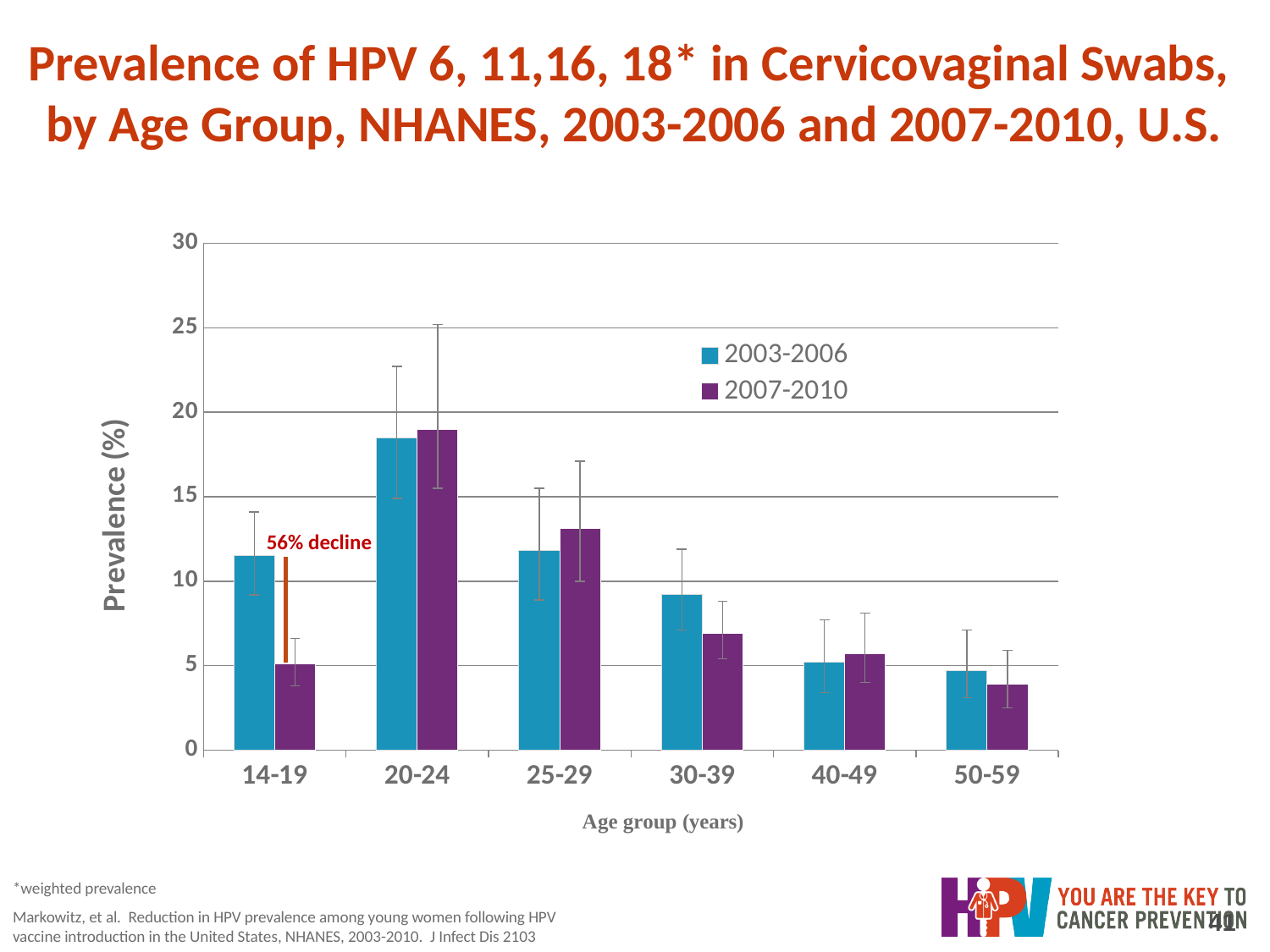
Which age group has the lowest prevalence for the 2007-2010 series? 50-59 How many series does the legend list? 2 Is the 2007-2010 prevalence for the 14-19 age group greater or less than 10? less For the 14-19 age group, which series has the larger prevalence, 2003-2006 or 2007-2010? 2003-2006 Which age group has the highest prevalence for the 2003-2006 series? 20-24 How many age groups are shown on the x axis? 6 Is the 2003-2006 prevalence for the 14-19 age group greater or less than 10? greater For the 30-39 age group, which series has the larger prevalence, 2003-2006 or 2007-2010? 2003-2006 Which age group has the highest prevalence for the 2007-2010 series? 20-24 Is the 2003-2006 prevalence for the 20-24 age group greater or less than 15? greater What kind of chart is shown on the slide? Bar chart What percentage decline is annotated on the chart for the 14-19 age group? 56% decline